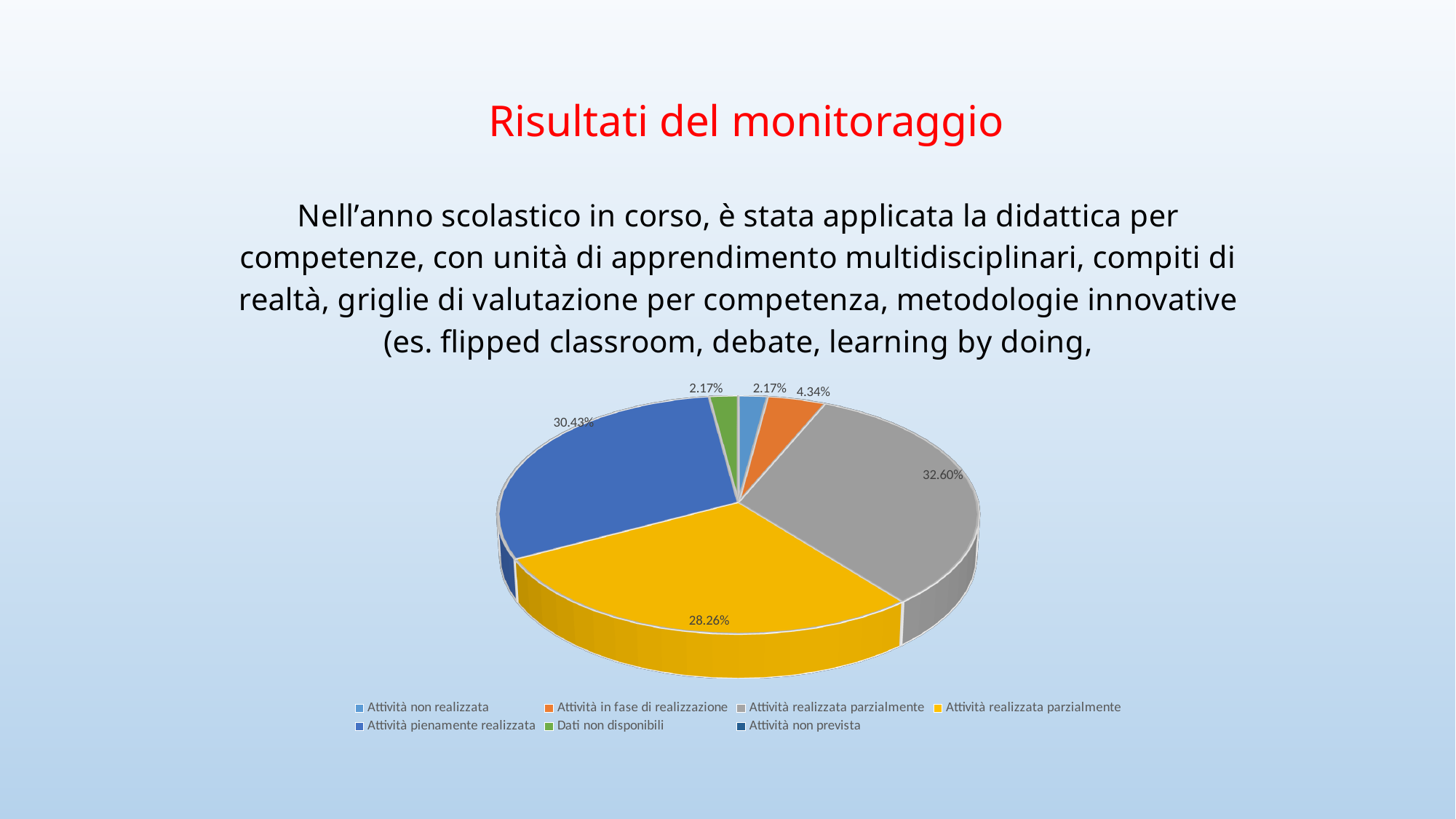
How many entries does the legend of the pie chart list? 7 What is the largest percentage shown on the pie chart? 32.60% What is the percentage of the yellow slice? 28.26% Which is larger, the slice for 'Attività in fase di realizzazione' or the slice for 'Attività non realizzata'? Attività in fase di realizzazione What percentage is shown for 'Dati non disponibili'? 2.17% What is the difference between the percentage for 'Attività pienamente realizzata' and the percentage for 'Attività in fase di realizzazione'? 26.09% What is the difference between the gray slice (32.60%) and the yellow slice (28.26%)? 4.34% What percentage is shown for 'Attività pienamente realizzata'? 30.43% What kind of chart is shown on the slide? pie chart What percentage is shown for 'Attività in fase di realizzazione'? 4.34% What colour is the slice for 'Attività pienamente realizzata'? blue What percentage is shown for 'Attività non realizzata'? 2.17%